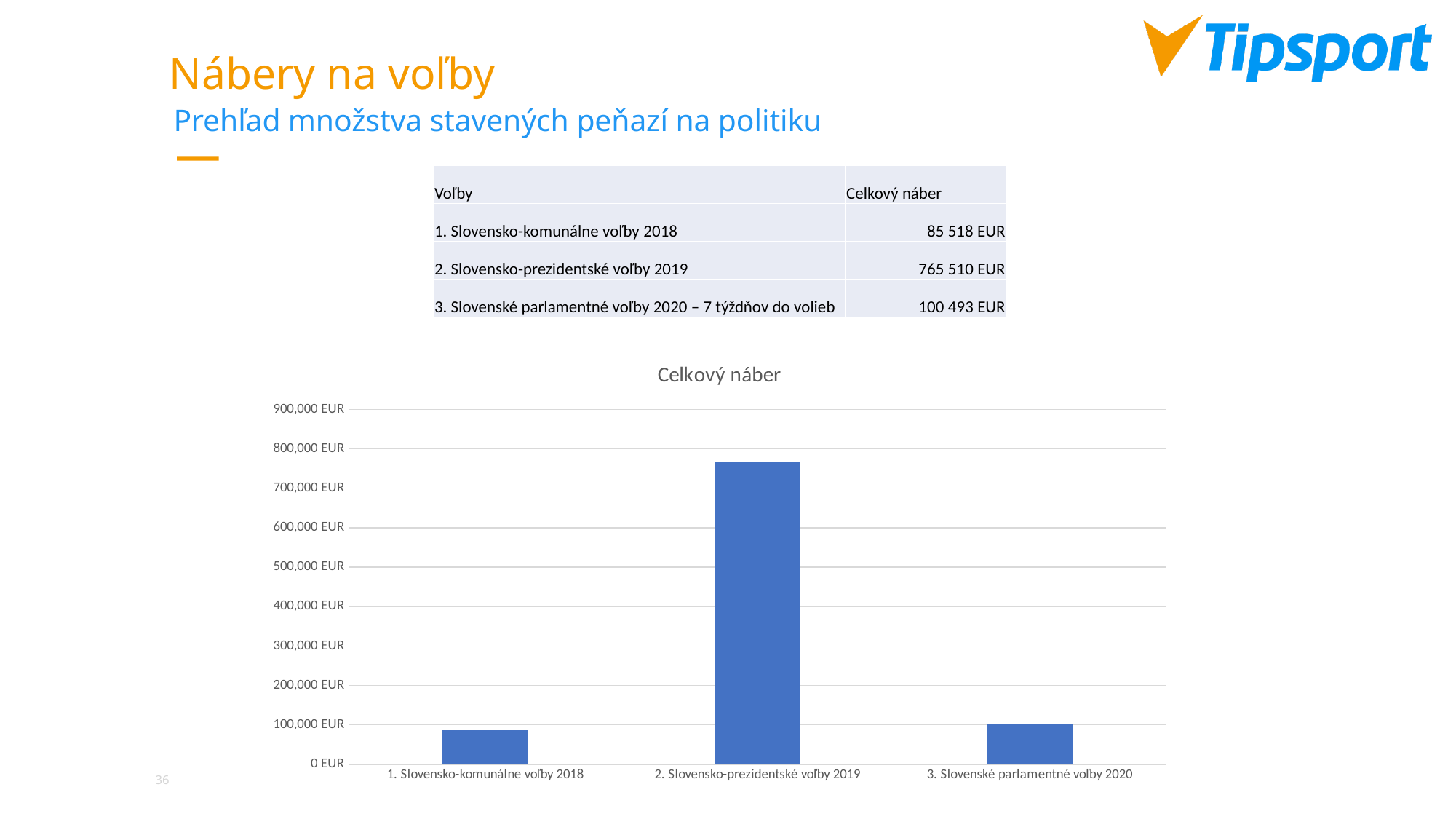
Which category has the lowest value in the chart? 1. Slovensko-komunálne voľby 2018 What is the Celkový náber for 3. Slovenské parlamentné voľby 2020? 100 493 EUR What is the difference between the values for 2. Slovensko-prezidentské voľby 2019 and 1. Slovensko-komunálne voľby 2018? 679 992 EUR Is the value for 1. Slovensko-komunálne voľby 2018 greater or less than 100,000 EUR? less Which is larger, the value for 3. Slovenské parlamentné voľby 2020 or for 1. Slovensko-komunálne voľby 2018? 3. Slovenské parlamentné voľby 2020 What is the title of the chart? Celkový náber How many categories are plotted in the chart? 3 Is the value for 2. Slovensko-prezidentské voľby 2019 greater or less than 700,000 EUR? greater What type of chart is shown on the slide? bar chart What is the Celkový náber for 1. Slovensko-komunálne voľby 2018? 85 518 EUR Which category has the highest value in the chart? 2. Slovensko-prezidentské voľby 2019 What is the Celkový náber for 2. Slovensko-prezidentské voľby 2019? 765 510 EUR